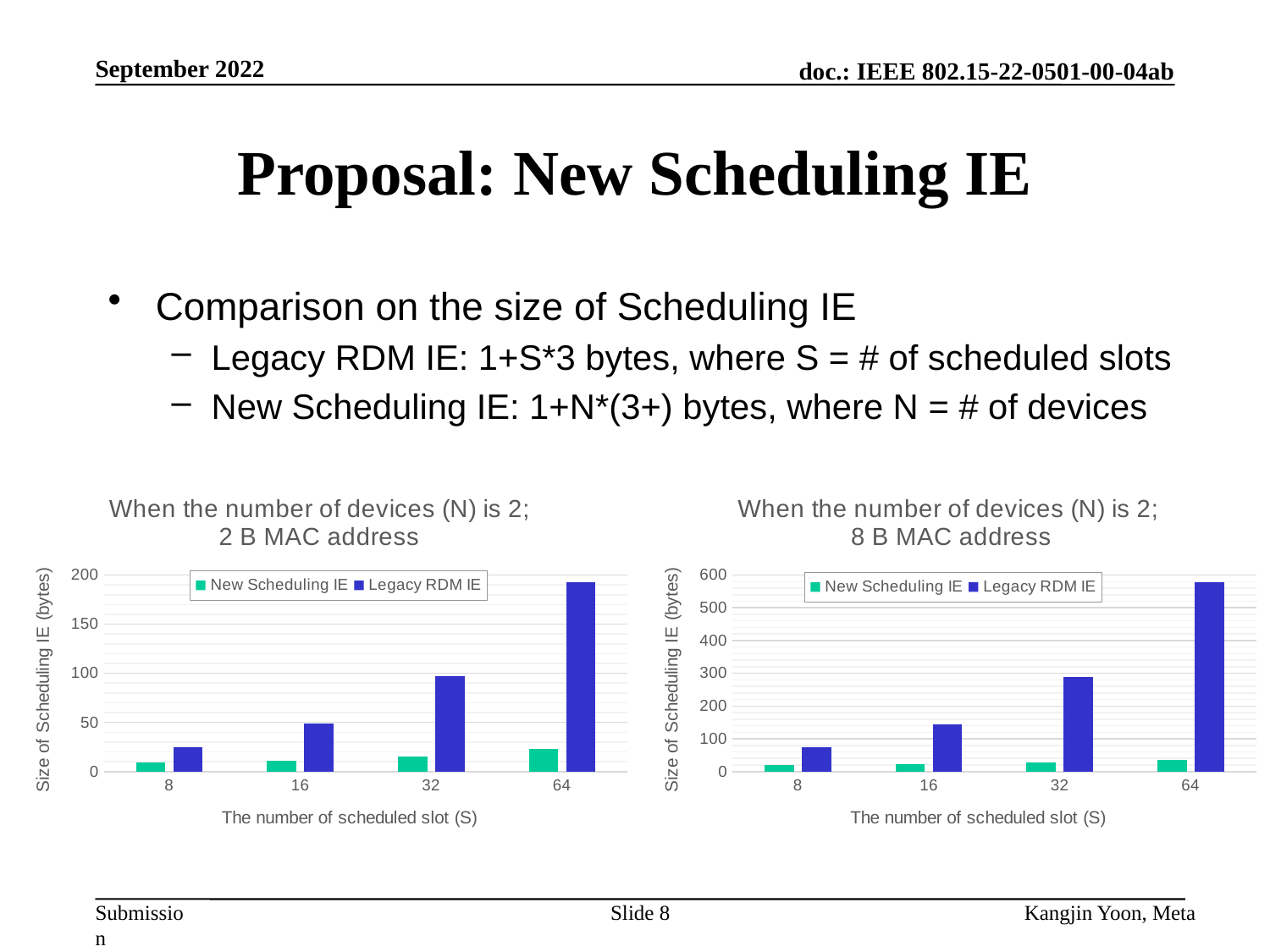
In the right chart (8 B MAC address), at which number of scheduled slots is the Legacy RDM IE value highest? 64 What kind of chart is the left chart titled 'When the number of devices (N) is 2; 2 B MAC address'? bar chart In the left chart (2 B MAC address), at S = 64, which series has the larger value: New Scheduling IE or Legacy RDM IE? Legacy RDM IE In the left chart (2 B MAC address), does the Legacy RDM IE value rise or fall as the number of scheduled slots increases? rise In the right chart (8 B MAC address), how many categories are shown on the x axis? 4 In the left chart (2 B MAC address), is the Legacy RDM IE value at S = 32 greater or less than 50? greater In the right chart (8 B MAC address), is the Legacy RDM IE value at S = 64 greater or less than 500? greater In the left chart (2 B MAC address), how many series does the legend list? 2 In the left chart (2 B MAC address), is the Legacy RDM IE value at S = 64 greater or less than 150? greater What is the label of the y axis on the right chart (8 B MAC address)? Size of Scheduling IE (bytes)